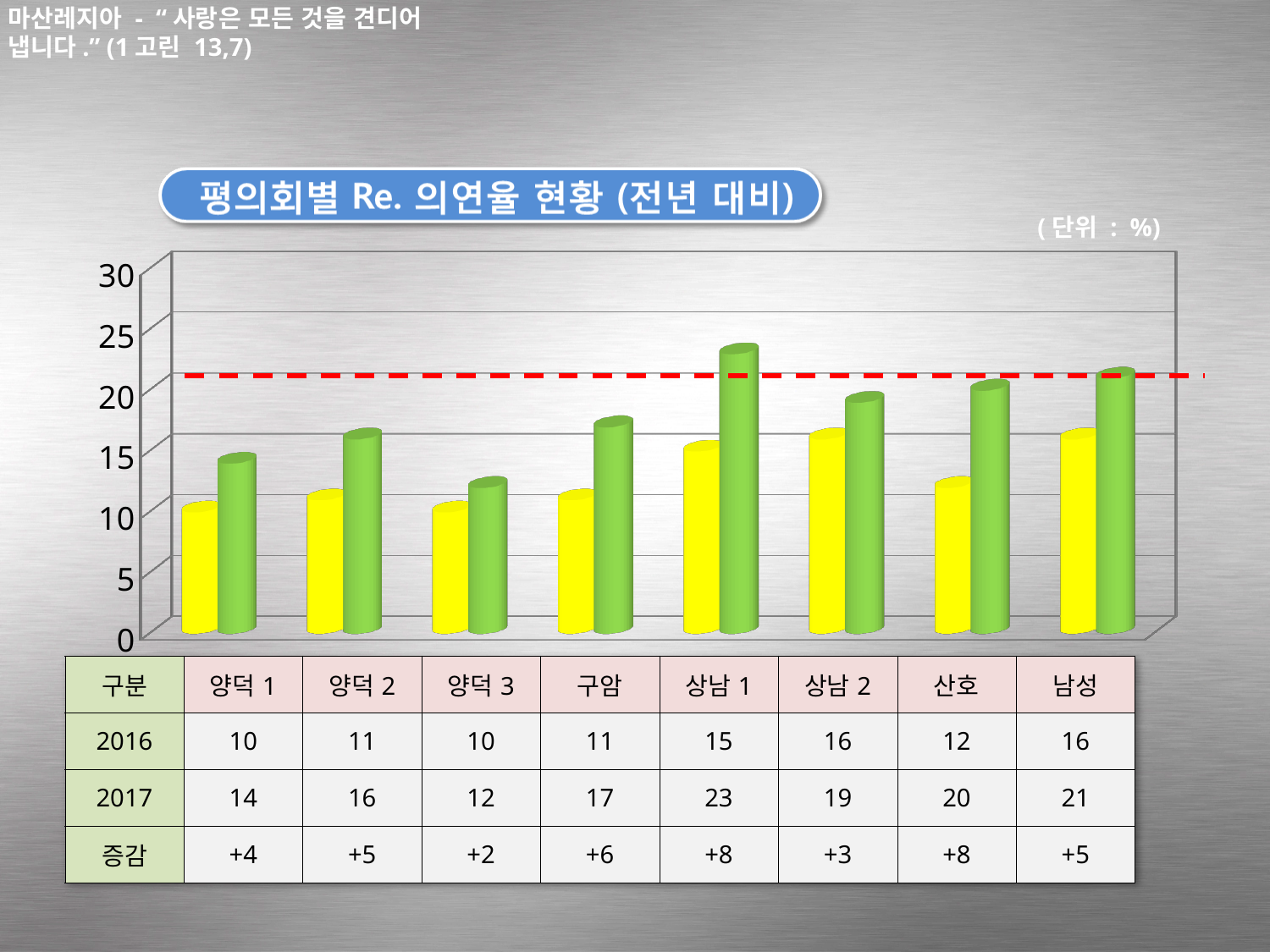
How many data series does the chart plot? 2 Which colour represents the 2017 series in the chart? green Which category has the lowest 2017 value? 양덕 3 What is the 2017 value for 상남 1? 23 How many categories are shown on the x axis of the chart? 8 What is the unit of the values shown in the chart? % Is the 2017 value for 상남 1 greater or less than 20? greater What is the 2016 value for 산호? 12 What kind of chart is shown on the slide? bar chart Which is larger, the 2017 value for 산호 or the 2017 value for 상남 2? 산호 Which category has the highest 2017 value? 상남 1 What is the difference between the 2017 and 2016 values for 구암? +6